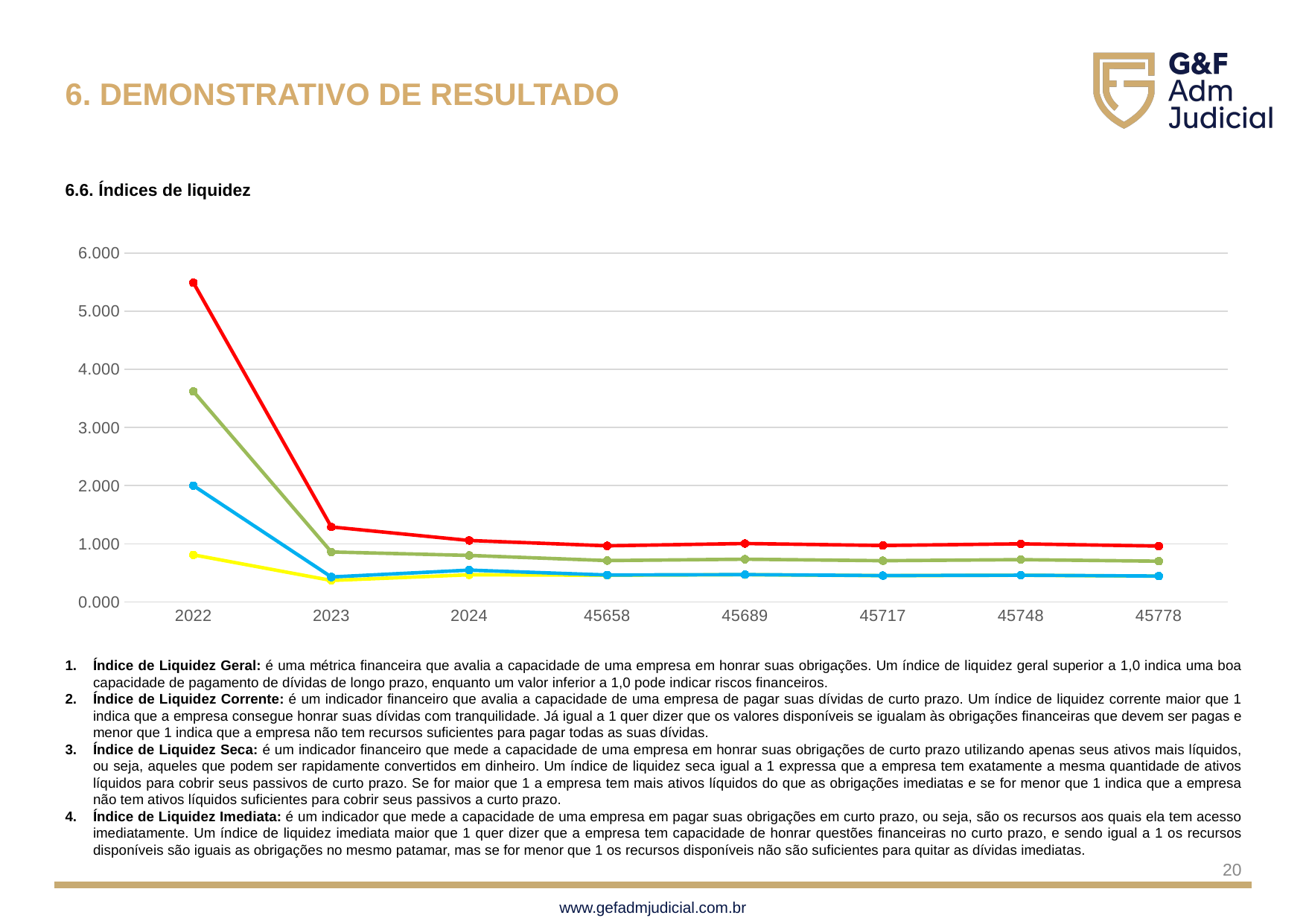
Is the value of the red line at 2023 greater or less than 1.000? greater Is the value of the green line at 2022 greater or less than 3.000? greater What is the heading above the chart? 6.6. Índices de liquidez At which x-axis category does the red line reach its highest value? 2022 What kind of chart is shown on the slide? line chart How many points are there along the x axis of the chart? 8 Is the value of the blue line at 45778 greater or less than 1.000? less At 2022, which line has the larger value, the red line or the green line? red line Does the red line rise or fall from 2022 to 2024? fall How many lines are plotted on the chart? 4